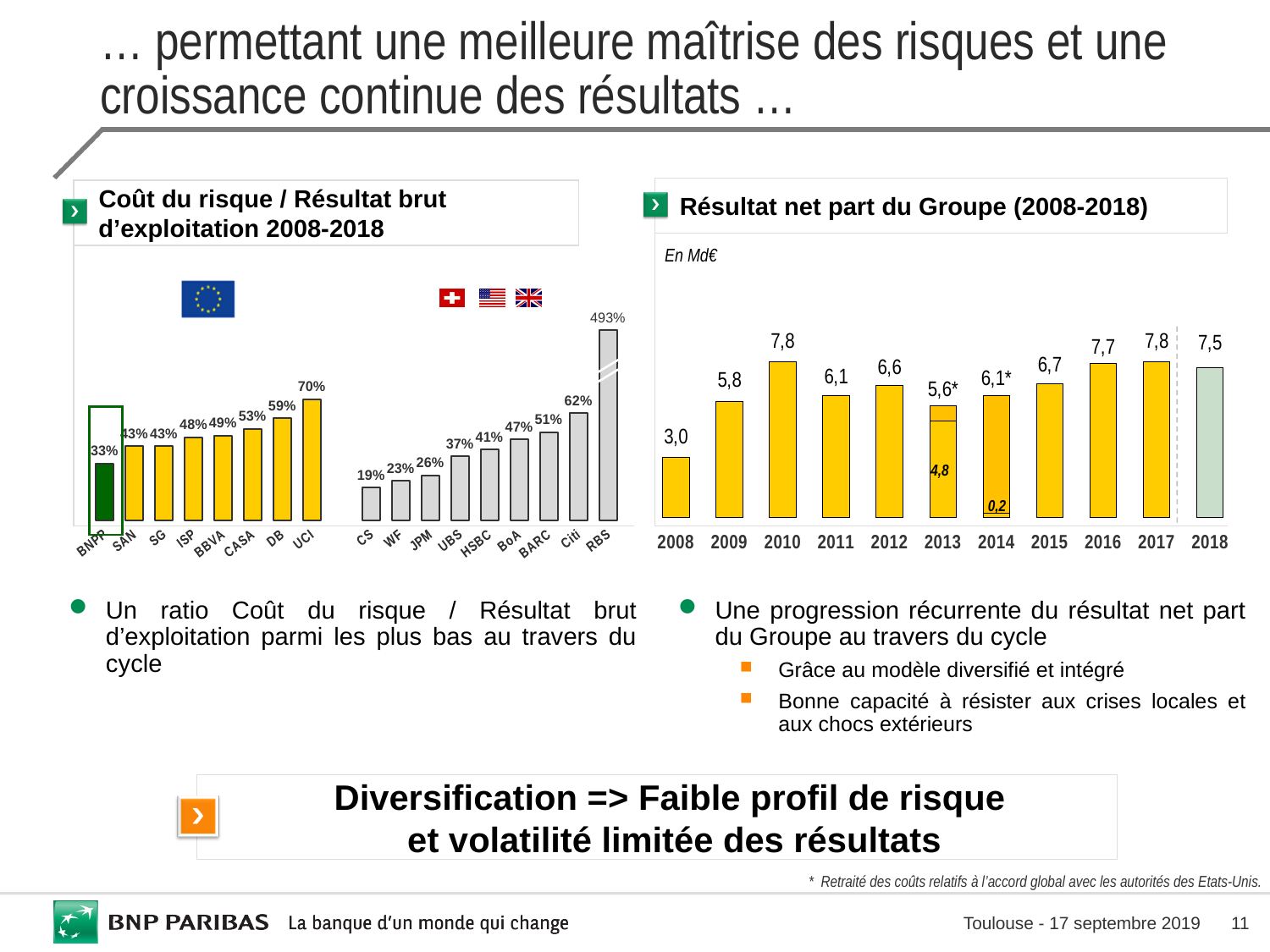
What kind of chart is 'Résultat net part du Groupe (2008-2018)'? Bar chart In the chart 'Coût du risque / Résultat brut d'exploitation 2008-2018', what is the value for UCI? 70% In the chart 'Coût du risque / Résultat brut d'exploitation 2008-2018', which bank has the lowest ratio? CS In the chart 'Résultat net part du Groupe (2008-2018)', which year has the lowest value? 2008 In the chart 'Résultat net part du Groupe (2008-2018)', what is the difference between the values for 2010 and 2008? 4,8 In the chart 'Résultat net part du Groupe (2008-2018)', which is larger, the value for 2012 or the value for 2015? 2015 In the chart 'Coût du risque / Résultat brut d'exploitation 2008-2018', which bank has the highest ratio? RBS In the chart 'Coût du risque / Résultat brut d'exploitation 2008-2018', what is the difference between the values for Citi and BNPP? 29% In the chart 'Coût du risque / Résultat brut d'exploitation 2008-2018', how many banks are shown? 17 In the chart 'Résultat net part du Groupe (2008-2018)', how many years are shown? 11 In the chart 'Coût du risque / Résultat brut d'exploitation 2008-2018', what is the value for BNPP? 33% In the chart 'Résultat net part du Groupe (2008-2018)', what is the value for 2018? 7,5